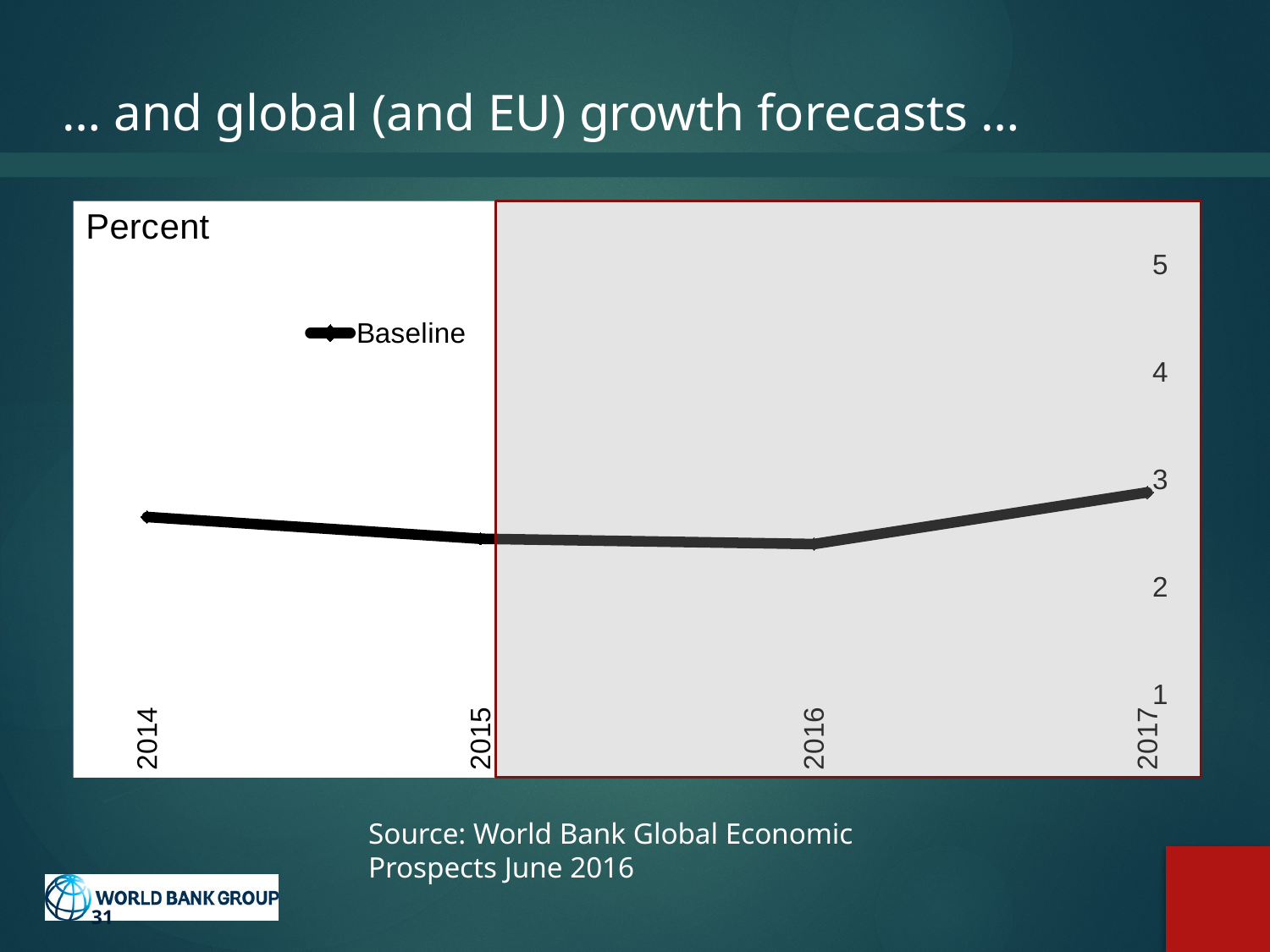
What is the name of the series shown in the legend? Baseline How many years are plotted along the x axis of the chart? 4 Is the Baseline value for 2017 greater or less than 2? greater Is the Baseline value for 2016 greater or less than 2? greater What kind of chart is shown on the slide? line chart How many series does the chart's legend list? 1 Is the Baseline value for 2014 greater or less than 3? less Does the Baseline line rise or fall from 2014 to 2016? fall Which is larger, the Baseline value for 2014 or for 2016? 2014 Which year has the highest Baseline value on the chart? 2017 What unit is indicated in the top-left corner of the chart? Percent